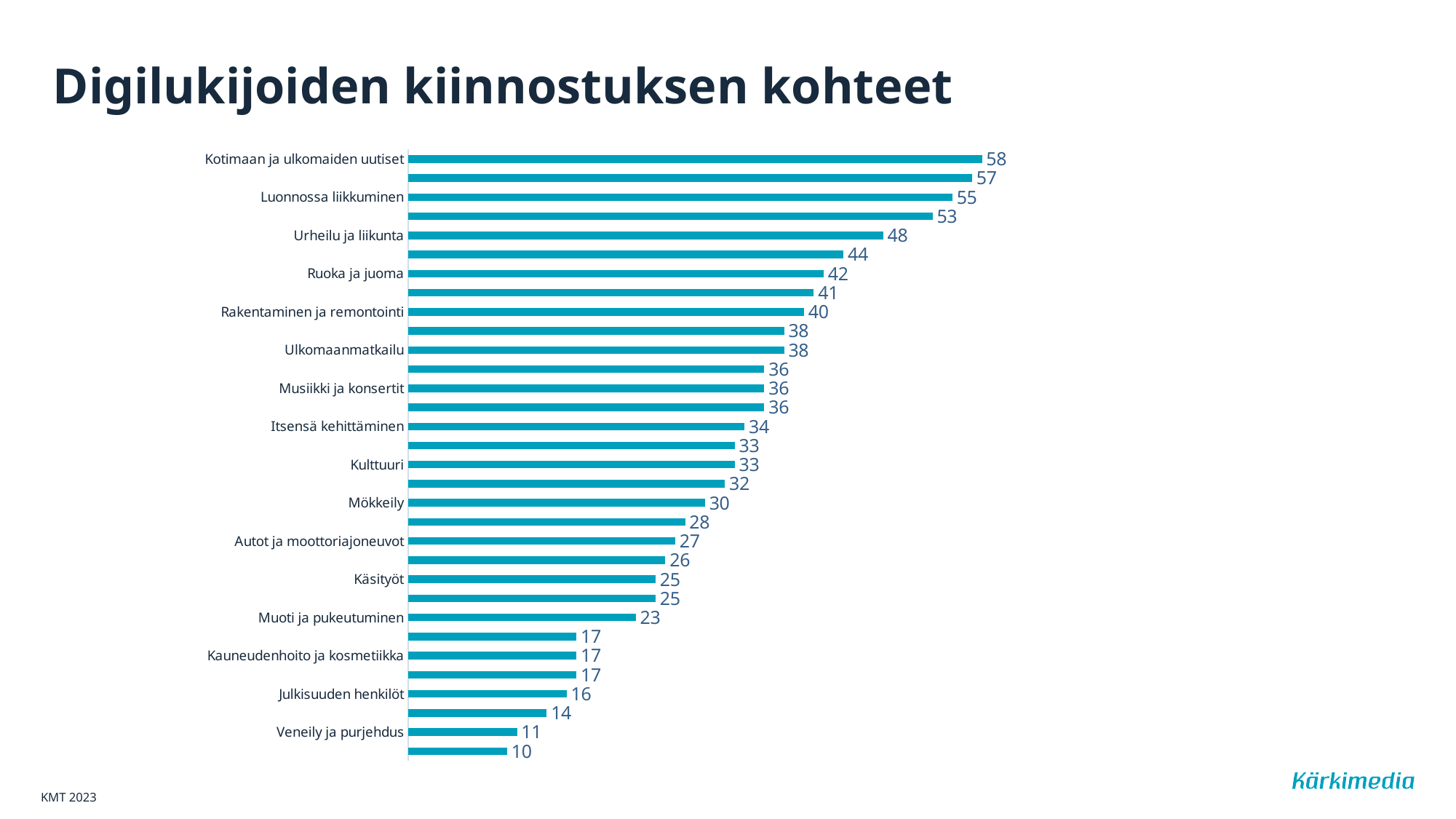
What is the value for Veneily ja purjehdus? 11 What is the value for Mökkeily? 30 What is the value for Luonnossa liikkuminen? 55 What is the lowest value shown on the chart? 10 What is the difference between the values for Mökkeily and Veneily ja purjehdus? 19 Which category has the highest value? Kotimaan ja ulkomaiden uutiset What is the value for Kotimaan ja ulkomaiden uutiset? 58 What is the value for Rakentaminen ja remontointi? 40 What is the difference between the values for Urheilu ja liikunta and Ruoka ja juoma? 6 What is the title of the chart on the slide? Digilukijoiden kiinnostuksen kohteet Which has a larger value, Kulttuuri or Käsityöt? Kulttuuri What kind of chart is shown on the slide? Bar chart